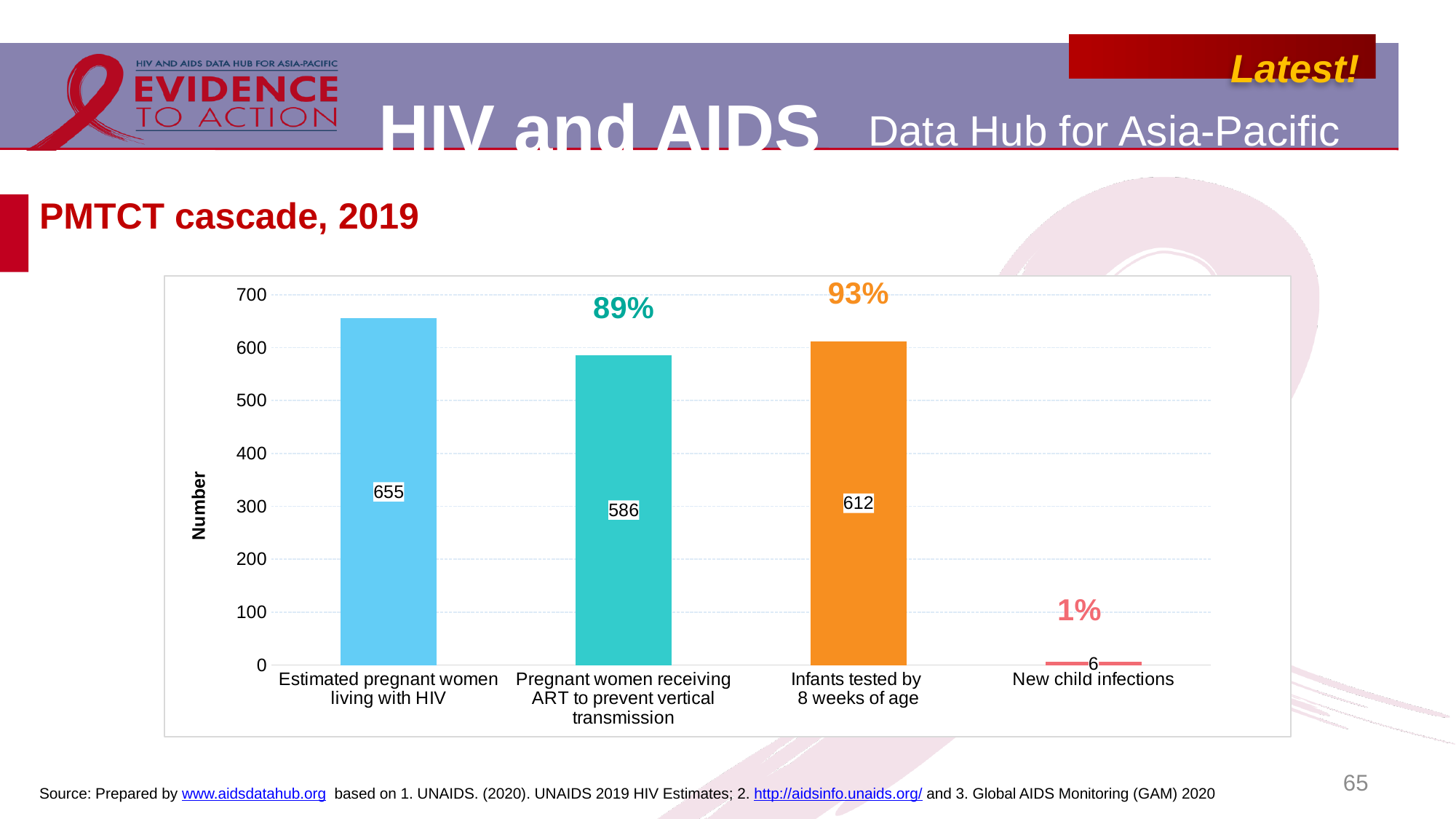
What is the value for New child infections? 6 What is the difference between Estimated pregnant women living with HIV and Pregnant women receiving ART to prevent vertical transmission? 69 What is the value for Infants tested by 8 weeks of age? 612 What kind of chart is shown? Bar chart What is the title of the chart? PMTCT cascade, 2019 What percentage is printed above the Infants tested by 8 weeks of age bar? 93% Which is larger: Infants tested by 8 weeks of age or Pregnant women receiving ART to prevent vertical transmission? Infants tested by 8 weeks of age How many categories are shown on the x axis? 4 Which category has the lowest value? New child infections Which category has the highest value? Estimated pregnant women living with HIV What is the value for Estimated pregnant women living with HIV? 655 What is the value for Pregnant women receiving ART to prevent vertical transmission? 586